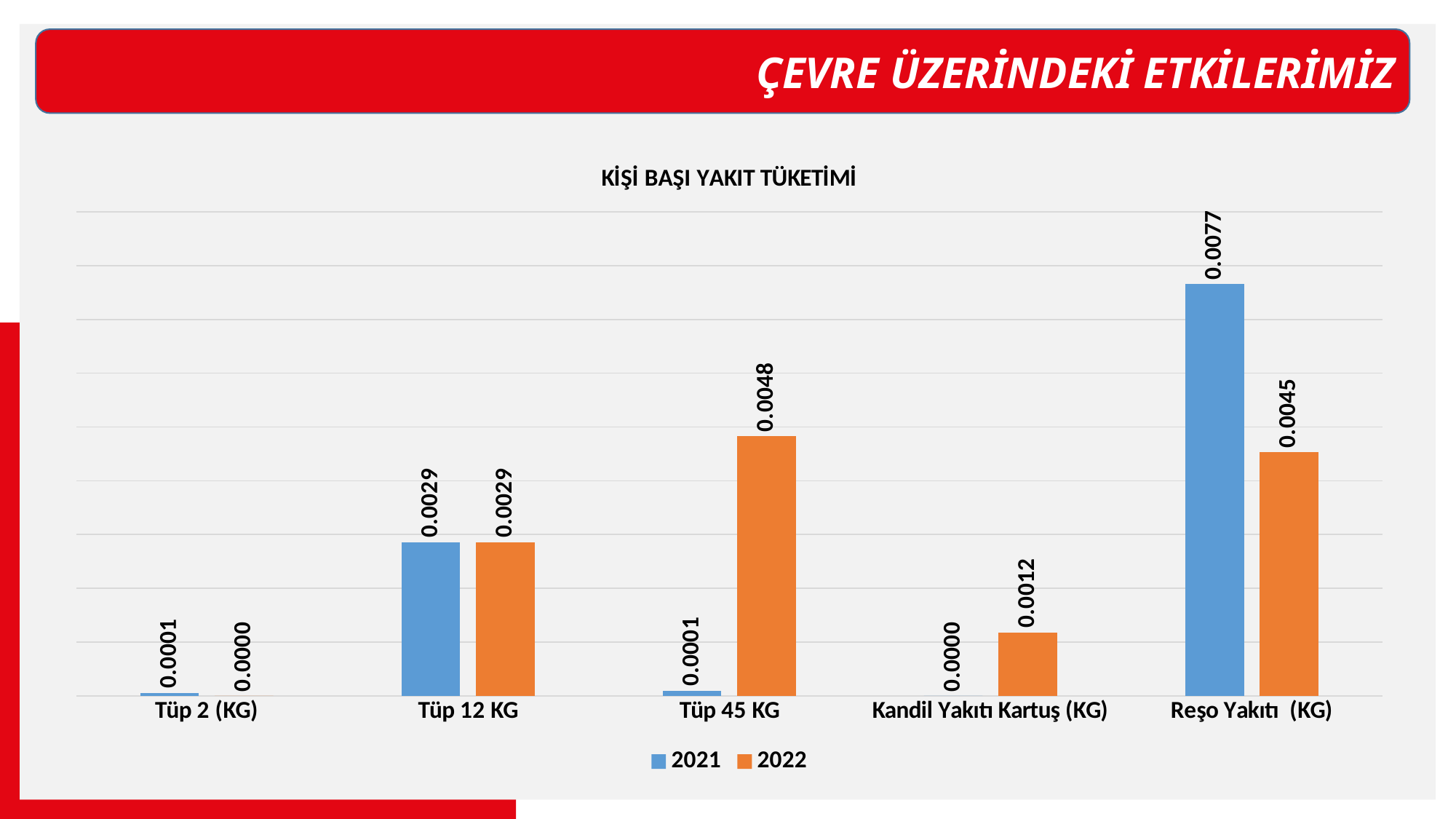
What is the 2022 value for Kandil Yakıtı Kartuş (KG)? 0.0012 How many categories are shown on the x axis? 5 Which category has the lowest 2022 value? Tüp 2 (KG) Which category has the highest 2021 value? Reşo Yakıtı (KG) What is the title of the chart? KİŞİ BAŞI YAKIT TÜKETİMİ Which is larger for Tüp 45 KG, the 2021 value or the 2022 value? 2022 What kind of chart is shown on the slide? Bar chart How many series does the legend list? 2 What is the 2021 value for Reşo Yakıtı (KG)? 0.0077 What is the 2022 value for Tüp 45 KG? 0.0048 What is the difference between the 2021 and 2022 values for Reşo Yakıtı (KG)? 0.0032 What is the 2021 value for Tüp 12 KG? 0.0029